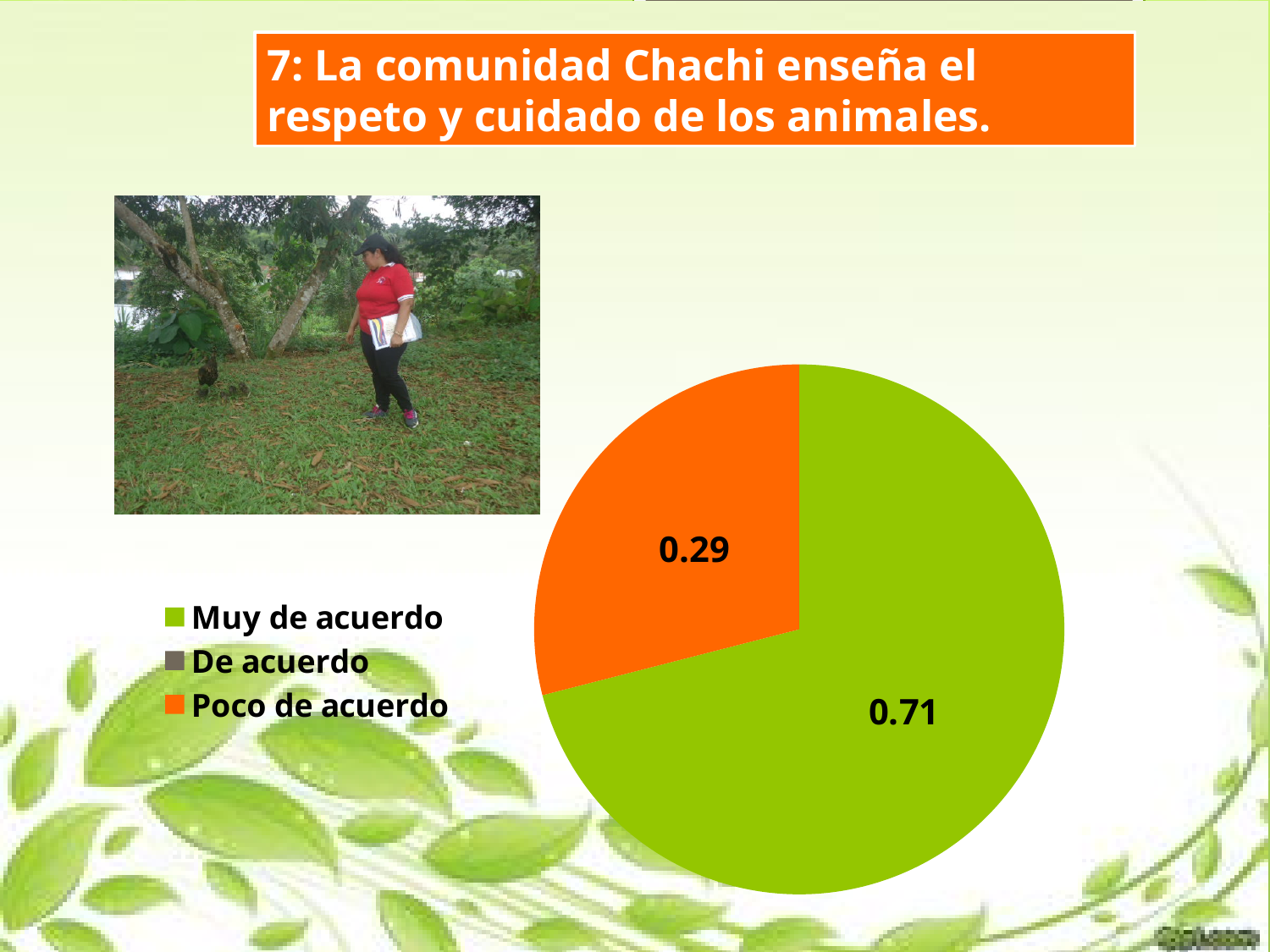
What value is shown for the Muy de acuerdo slice of the pie chart? 0.71 Of the two labelled slices, which one is smaller? Poco de acuerdo What is the difference between the Muy de acuerdo value and the Poco de acuerdo value? 0.42 What value is shown for the Poco de acuerdo slice of the pie chart? 0.29 How many slices with data labels are visible in the pie chart? 2 Which category has the largest slice in the pie chart? Muy de acuerdo What is the title of the slide containing the pie chart? 7: La comunidad Chachi enseña el respeto y cuidado de los animales. Which is larger, the Muy de acuerdo slice or the Poco de acuerdo slice? Muy de acuerdo How many entries does the legend of the pie chart list? 3 What share of the pie does the Muy de acuerdo slice represent? 0.71 What type of chart is shown on the slide? Pie chart Which colour represents Poco de acuerdo in the pie chart? Orange